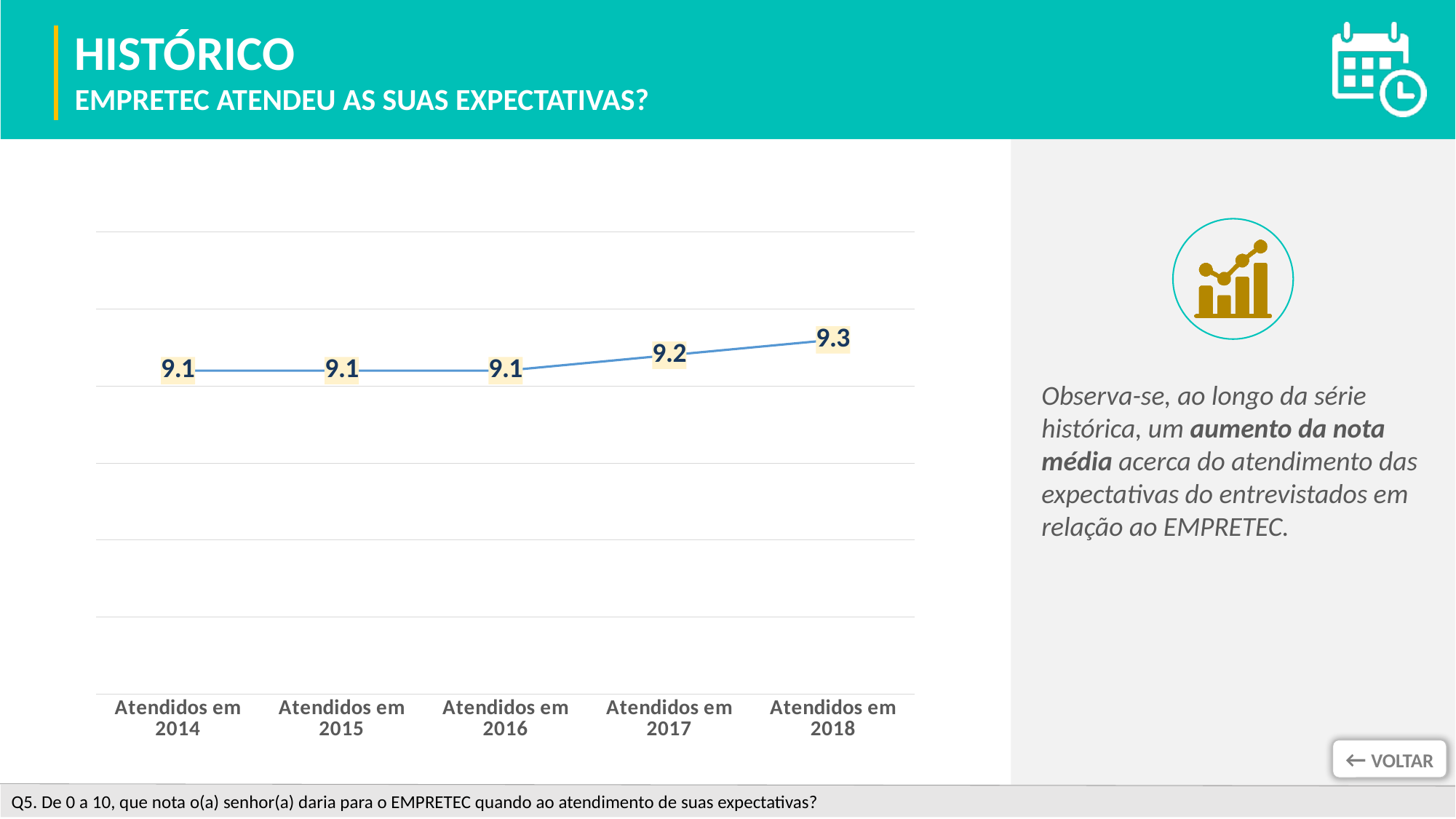
What is the subtitle of the slide above the chart? EMPRETEC ATENDEU AS SUAS EXPECTATIVAS? What is the value for Atendidos em 2018? 9.3 What is the value for Atendidos em 2016? 9.1 What is the value for Atendidos em 2014? 9.1 Which is larger, the value for Atendidos em 2018 or the value for Atendidos em 2017? Atendidos em 2018 How many data points are plotted on the chart? 5 What is the value for Atendidos em 2017? 9.2 What kind of chart is shown on the slide? line chart What is the difference between the values for Atendidos em 2017 and Atendidos em 2016? 0.1 Do the values rise or fall from 2014 to 2018? rise Which category has the highest value? Atendidos em 2018 What is the difference between the values for Atendidos em 2018 and Atendidos em 2014? 0.2